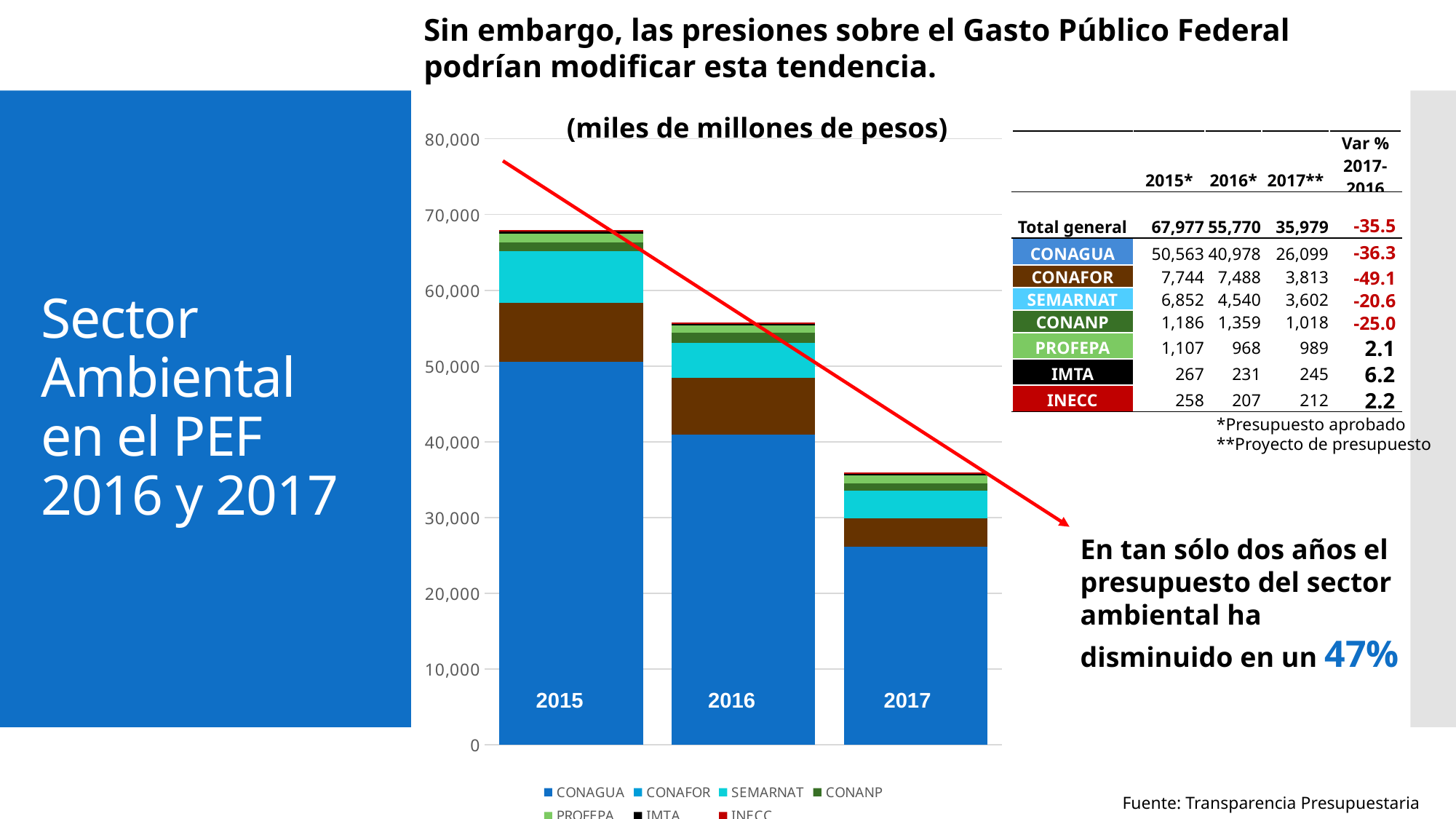
According to the table, what is the CONAGUA value for 2017? 26,099 According to the table, what is the Total general for 2015? 67,977 In 2015, which is larger according to the table: CONAFOR or SEMARNAT? CONAFOR Which year has the tallest stacked bar? 2015 Is the total value of the 2016 bar greater or less than 50,000? greater Do the total bar heights rise or fall from 2015 to 2017? Fall Is the total value of the 2017 bar greater or less than 40,000? less What is the difference between the Total general for 2015 and for 2017, as given in the table? 31,998 Which year has the shortest stacked bar? 2017 What kind of chart is shown on the slide? Stacked bar chart How many years (bars) are plotted in the chart? 3 How many series does the chart legend list? 7